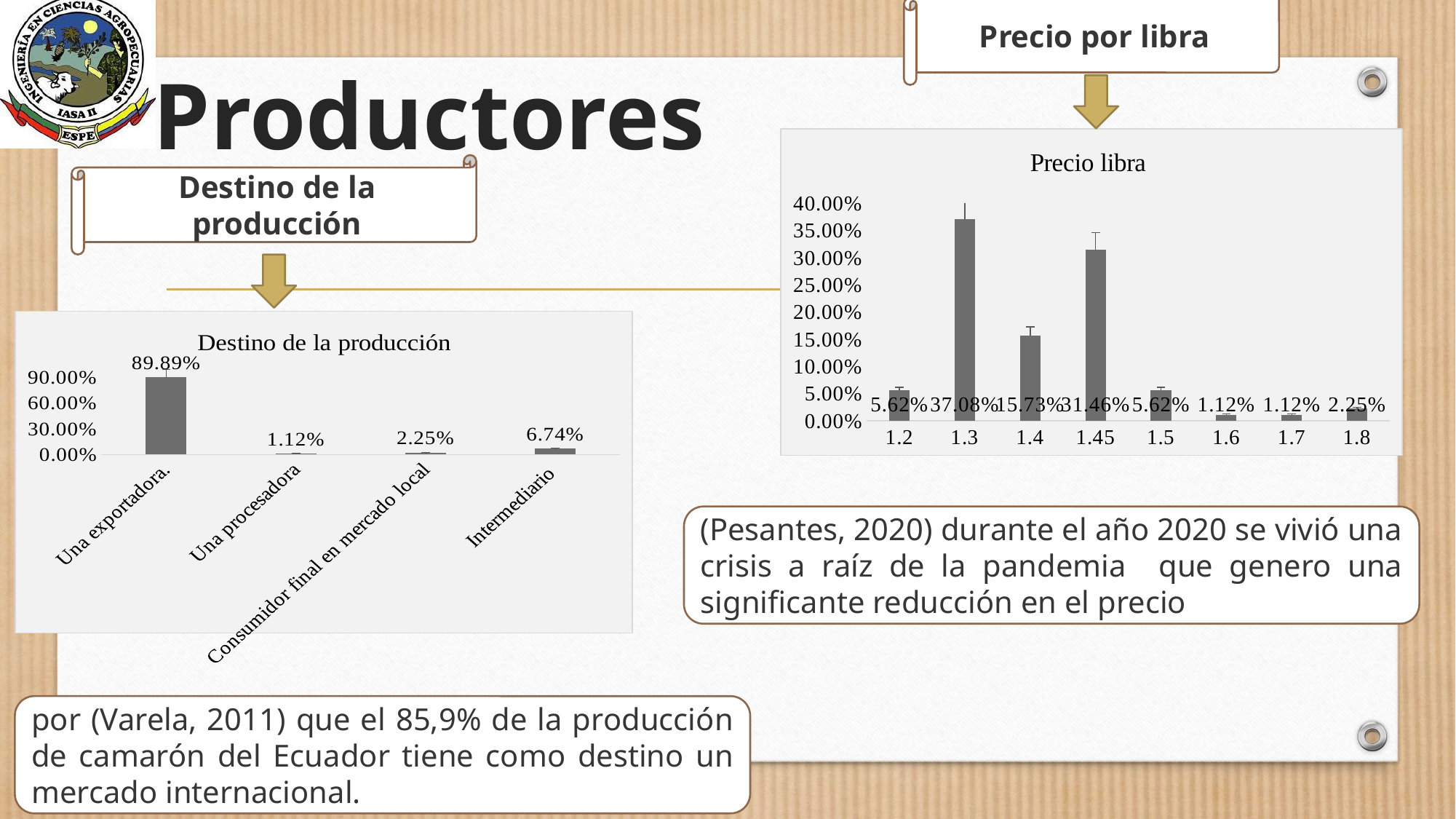
In the 'Precio libra' chart, what is the value for 1.3? 37.08% In the 'Precio libra' chart, what is the value for 1.45? 31.46% In the 'Destino de la producción' chart, what is the value for Una exportadora? 89.89% In the 'Precio libra' chart, how many price categories are shown on the x axis? 8 In the 'Destino de la producción' chart, what is the value for Intermediario? 6.74% In the 'Destino de la producción' chart, which category has the lowest value? Una procesadora What kind of chart is the 'Precio libra' chart? Bar chart In the 'Precio libra' chart, which price has the highest value? 1.3 In the 'Precio libra' chart, which is larger, the value for 1.4 or the value for 1.45? 1.45 In the 'Precio libra' chart, what is the difference between the values for 1.3 and 1.45? 5.62% In the 'Destino de la producción' chart, what is the difference between Intermediario and Consumidor final en mercado local? 4.49% In the 'Destino de la producción' chart, how many categories are shown? 4